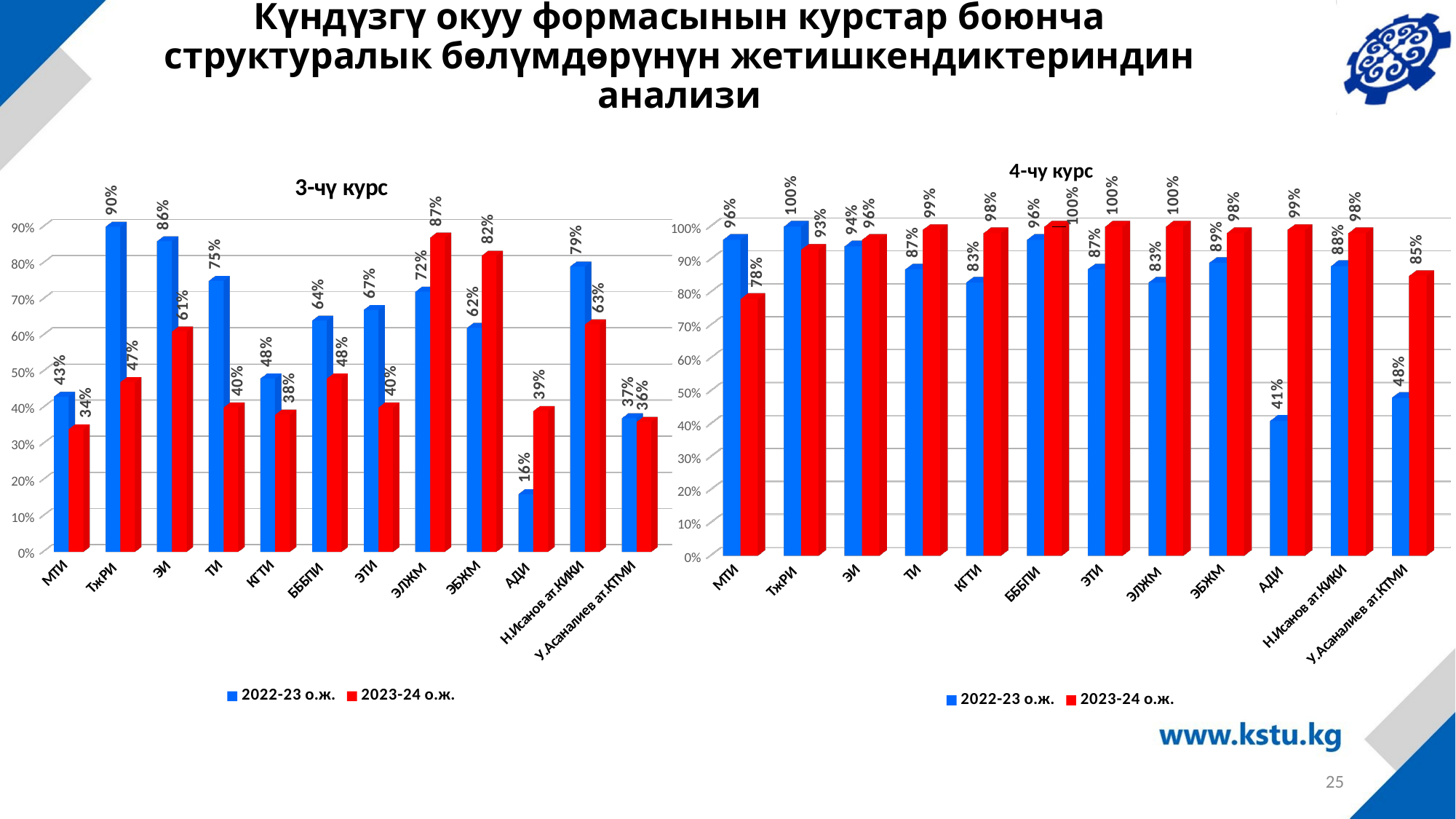
In the "4-чү курс" chart, what is the value for МТИ in the 2023-24 о.ж. series? 78% In the "3-чү курс" chart, what is the difference between the 2022-23 о.ж. and 2023-24 о.ж. values for ТИ? 35% How many series does the legend of the "4-чү курс" chart list? 2 In the "4-чү курс" chart, what is the difference between the 2023-24 о.ж. and 2022-23 о.ж. values for У.Асаналиев ат.КТМИ? 37% In the "4-чү курс" chart, which is larger for ЭИ: the 2022-23 о.ж. value or the 2023-24 о.ж. value? 2023-24 о.ж. In the "3-чү курс" chart, which category has the highest 2023-24 о.ж. value? ЭЛЖМ In the "3-чү курс" chart, which category has the lowest 2022-23 о.ж. value? АДИ In the "3-чү курс" chart, how many categories are shown on the x axis? 12 In the "3-чү курс" chart, what is the value for ТжРИ in the 2022-23 о.ж. series? 90% In the "3-чү курс" chart, what is the value for АДИ in the 2023-24 о.ж. series? 39% In the "4-чү курс" chart, what is the value for АДИ in the 2022-23 о.ж. series? 41% What type of chart is the "3-чү курс" chart? Bar chart